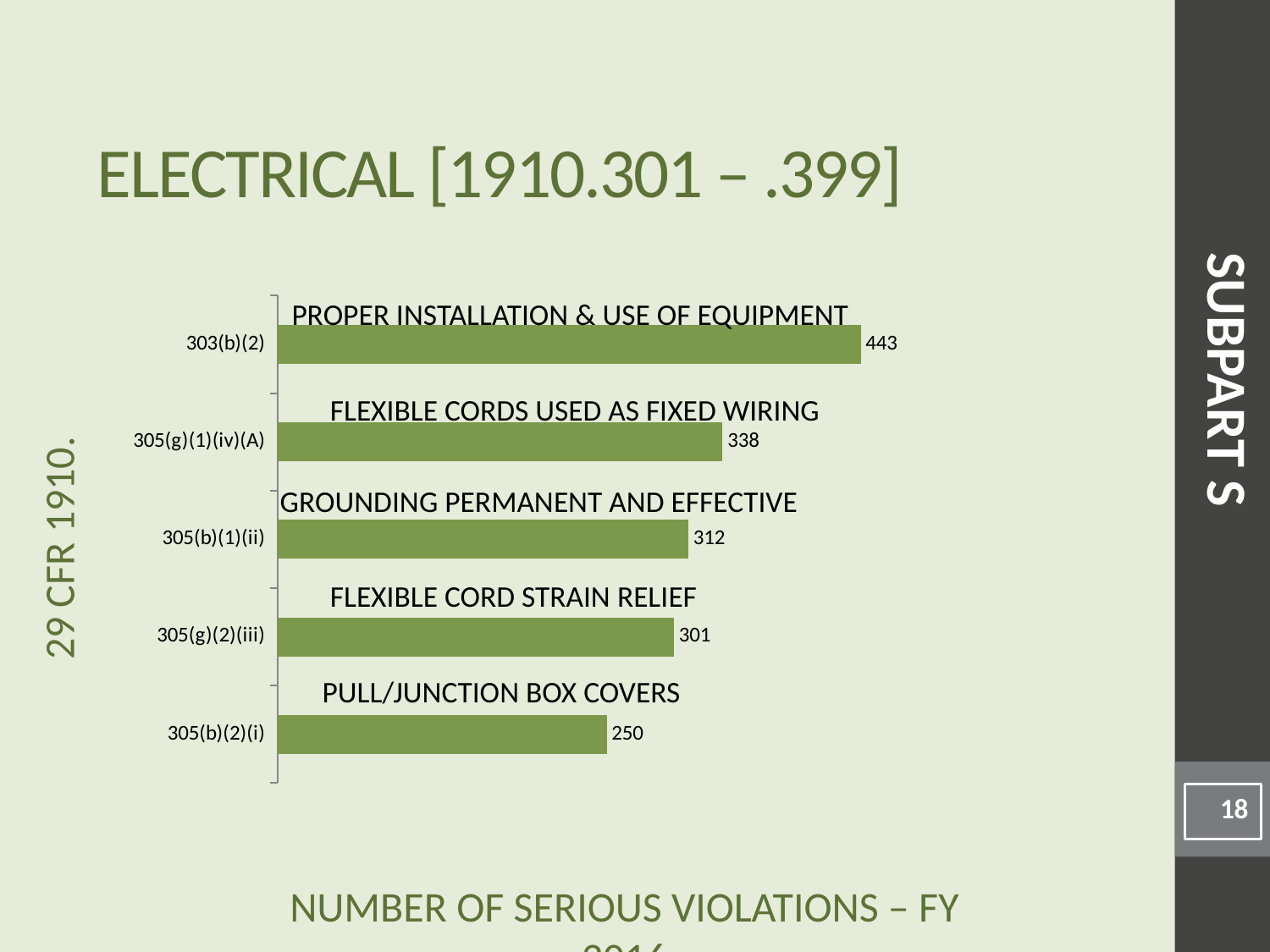
Which category has the lowest number of serious violations? 305(b)(2)(i) (Pull/Junction Box Covers) What is the number of serious violations for 305(g)(1)(iv)(A) (Flexible Cords Used as Fixed Wiring)? 338 What is the number of serious violations for 305(b)(2)(i) (Pull/Junction Box Covers)? 250 What is the number of serious violations for 303(b)(2) (Proper Installation & Use of Equipment)? 443 How many categories are shown in the chart? 5 What is the difference in serious violations between 303(b)(2) and 305(b)(2)(i)? 193 What is the number of serious violations for 305(b)(1)(ii) (Grounding Permanent and Effective)? 312 What is the number of serious violations for 305(g)(2)(iii) (Flexible Cord Strain Relief)? 301 What type of chart is shown on the slide? Bar chart Which has more serious violations, Grounding Permanent and Effective or Flexible Cord Strain Relief? Grounding Permanent and Effective What is the difference in serious violations between 305(g)(1)(iv)(A) and 305(b)(1)(ii)? 26 Which category has the highest number of serious violations? 303(b)(2) (Proper Installation & Use of Equipment)